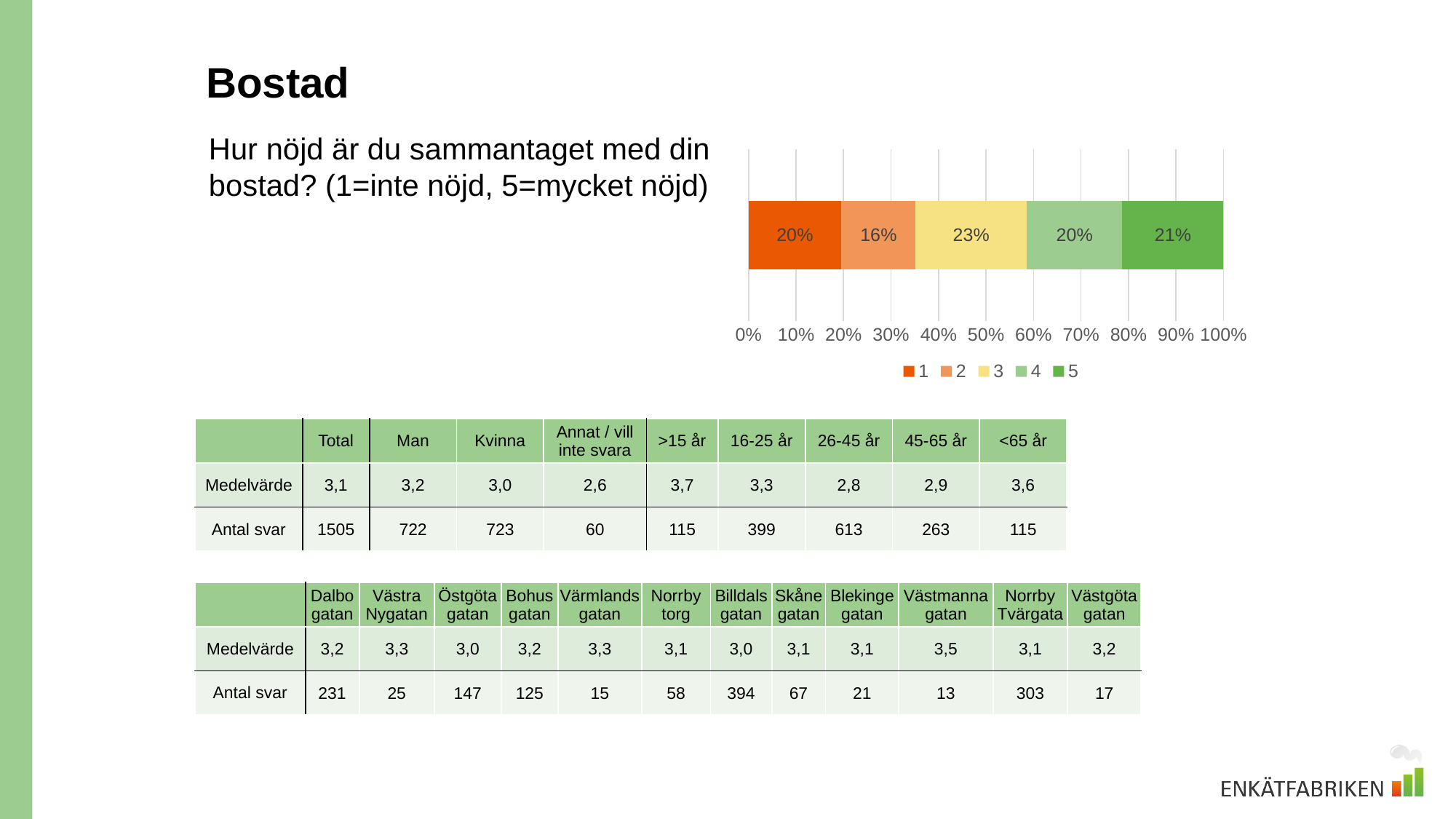
Which has a larger share in the chart, rating 5 or rating 2? 5 How many series does the legend of the chart list? 5 What share of respondents gave a rating of 2 in the chart? 16% What share of respondents gave a rating of 1 in the chart? 20% Which rating has the smallest share in the chart? 2 What is the difference in percentage points between the share for rating 3 and the share for rating 2? 7 What share of respondents gave a rating of 5 in the chart? 21% Which rating has the largest share in the chart? 3 What colour is the segment for rating 1 in the chart? Orange-red What kind of chart is shown on the slide? Stacked bar chart What is the total of all segments in the stacked bar? 100% What share of respondents gave a rating of 3 in the chart? 23%